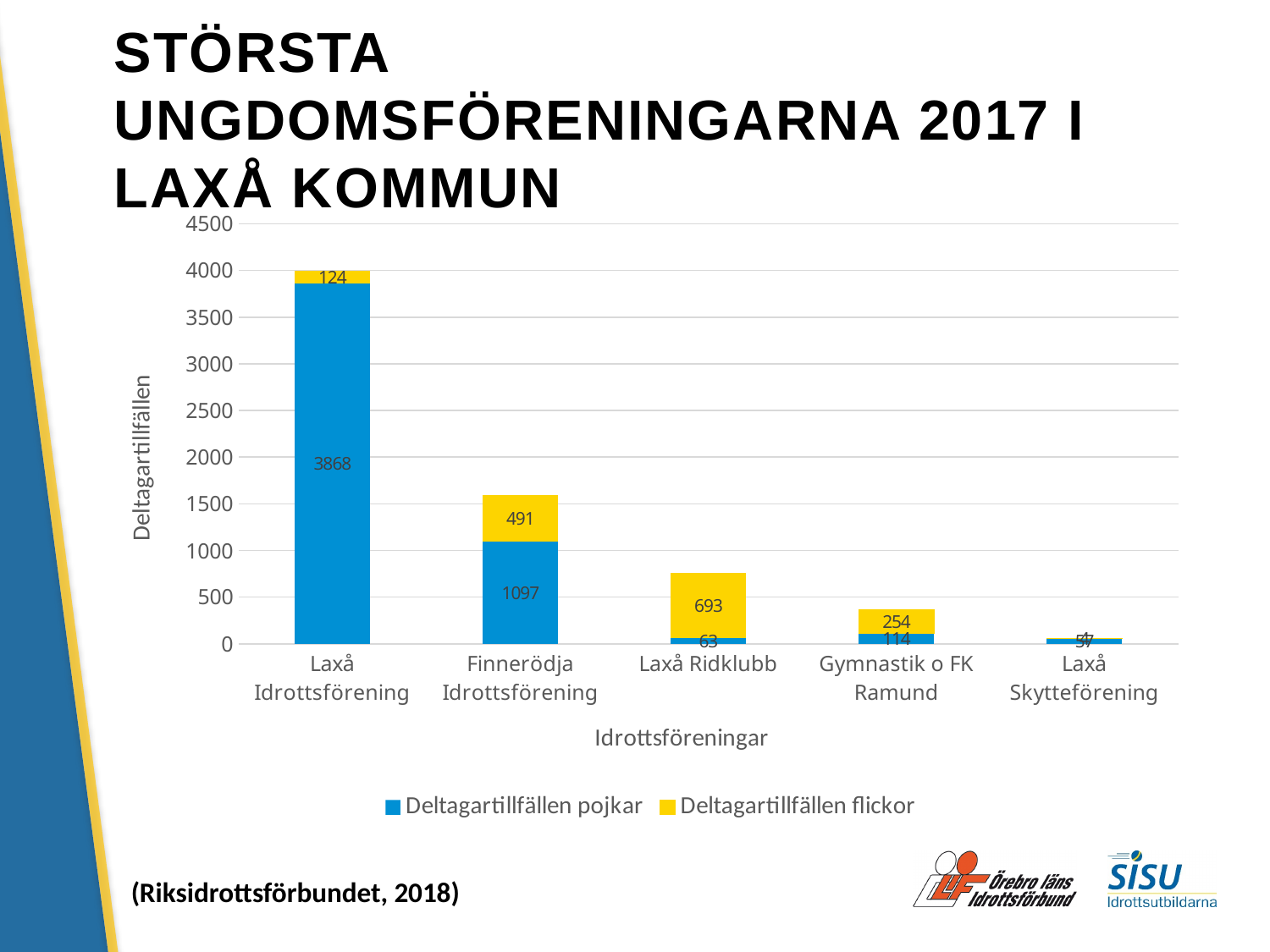
How many series does the legend list? 2 What is the value of Deltagartillfällen pojkar for Laxå Idrottsförening? 3868 For Gymnastik o FK Ramund, which is larger: Deltagartillfällen pojkar or Deltagartillfällen flickor? Deltagartillfällen flickor How many sports clubs (categories) are shown on the x axis? 5 What is the value of Deltagartillfällen pojkar for Gymnastik o FK Ramund? 114 What is the difference between Deltagartillfällen flickor and Deltagartillfällen pojkar for Laxå Ridklubb? 630 What is the value of Deltagartillfällen flickor for Laxå Ridklubb? 693 What kind of chart is shown on the slide? Stacked bar chart What is the total Deltagartillfällen (pojkar plus flickor) for Finnerödja Idrottsförening? 1588 Which club has the highest total Deltagartillfällen? Laxå Idrottsförening What is the value of Deltagartillfällen flickor for Finnerödja Idrottsförening? 491 What is the label of the y axis? Deltagartillfällen